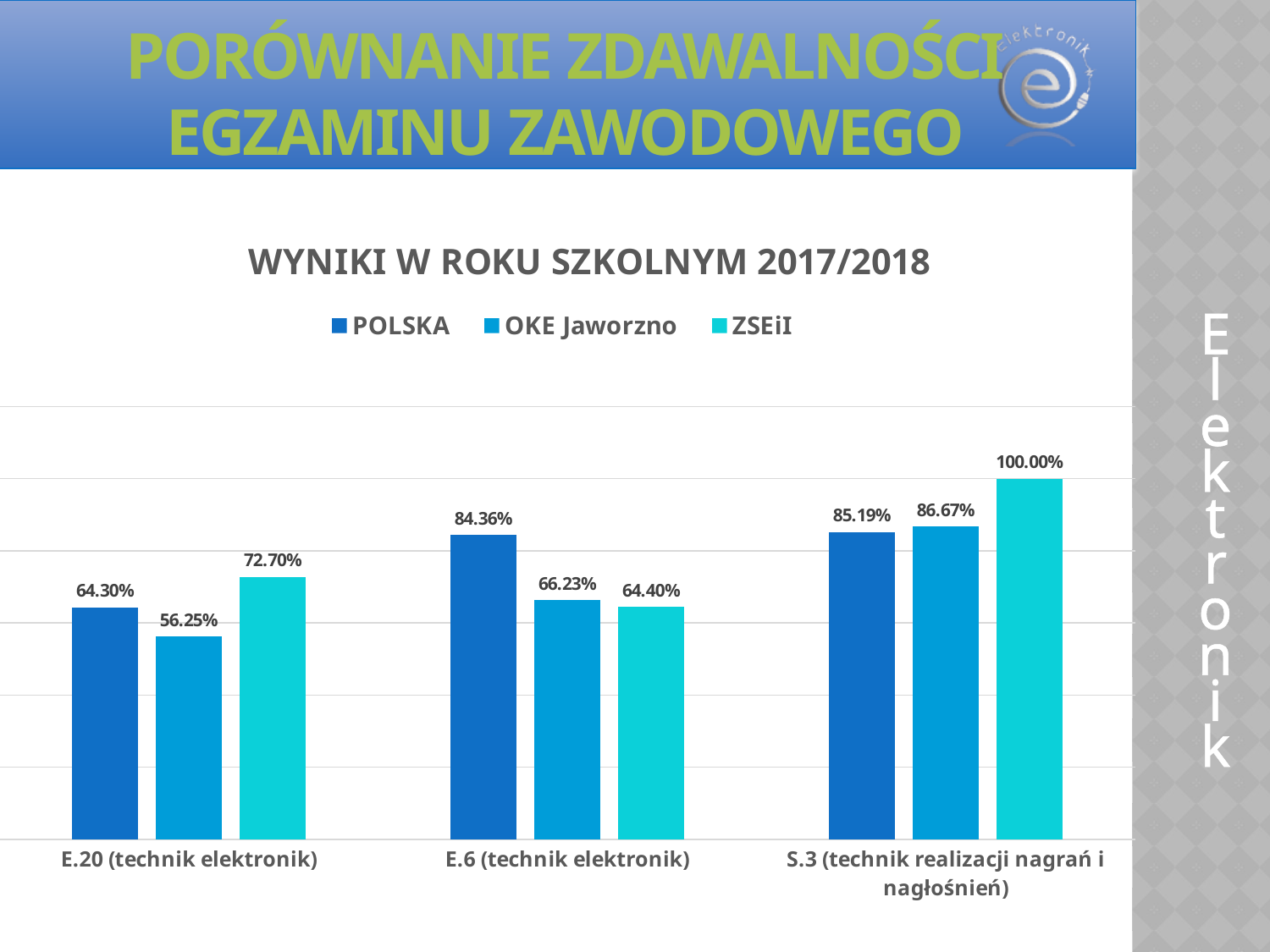
What is the OKE Jaworzno value for E.20 (technik elektronik)? 56.25% Which category has the highest ZSEiI value? S.3 (technik realizacji nagrań i nagłośnień) What is the ZSEiI value for E.20 (technik elektronik)? 72.70% What is the POLSKA value for E.6 (technik elektronik)? 84.36% What kind of chart is shown on the slide? Bar chart How many series does the legend list? 3 For E.6 (technik elektronik), which is larger: the POLSKA value or the ZSEiI value? POLSKA What is the title of the chart? WYNIKI W ROKU SZKOLNYM 2017/2018 How many categories are shown on the x axis? 3 What is the OKE Jaworzno value for S.3 (technik realizacji nagrań i nagłośnień)? 86.67% Which category has the lowest OKE Jaworzno value? E.20 (technik elektronik) What is the difference between the ZSEiI and POLSKA values for E.20 (technik elektronik)? 8.40%